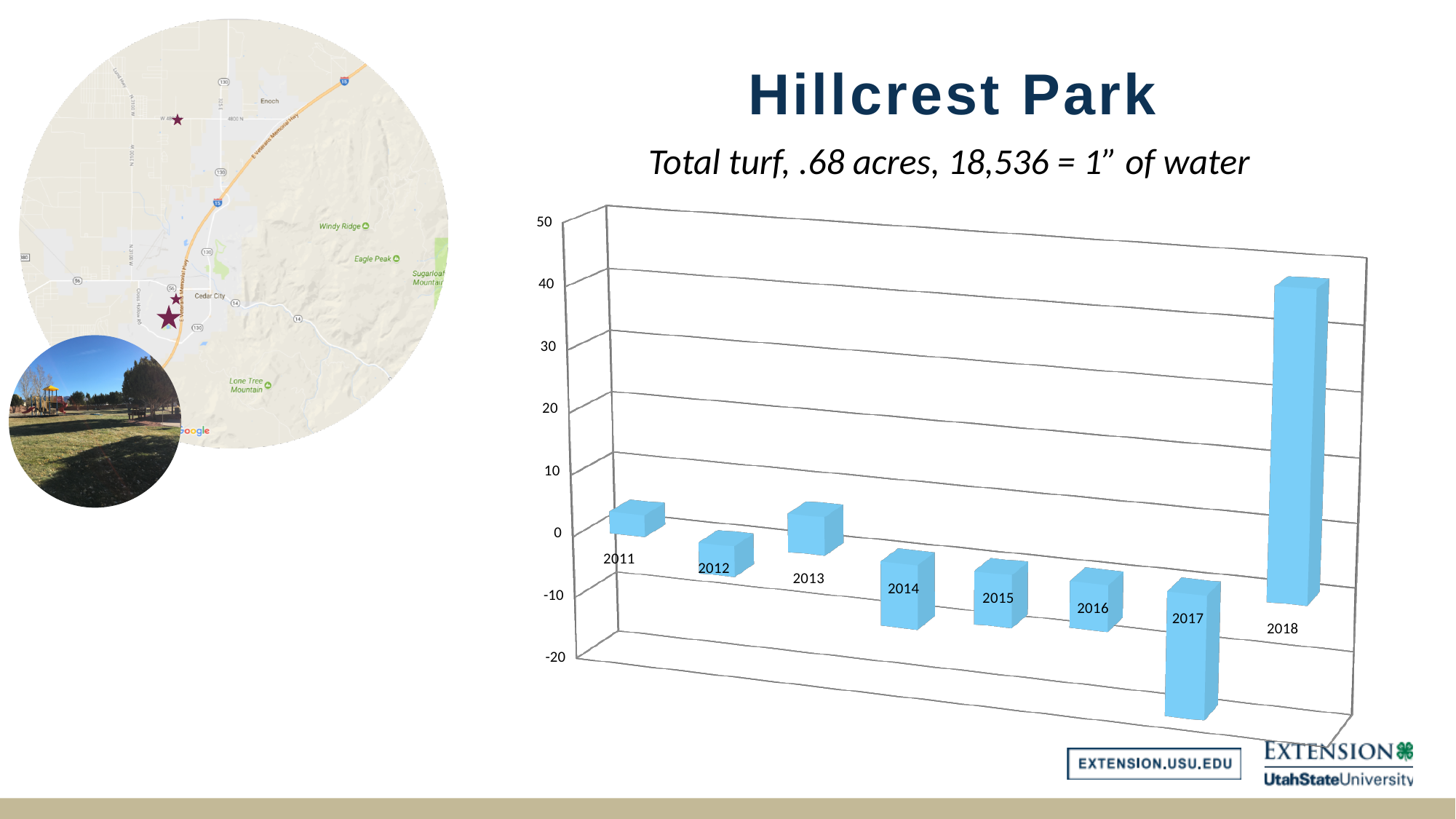
Is the value for 2017 greater or less than -10? less Which year has the lowest value on the chart? 2017 What is the title of the slide containing the chart? Hillcrest Park What kind of chart is shown on the slide? bar chart Is the value for 2011 greater or less than 0? greater Is the value for 2018 greater or less than 30? greater What is the lowest value shown on the chart's vertical axis? -20 Which year has the highest value on the chart? 2018 Which has the larger value, 2013 or 2014? 2013 How many years are plotted on the chart? 8 Which has the larger value, 2018 or 2017? 2018